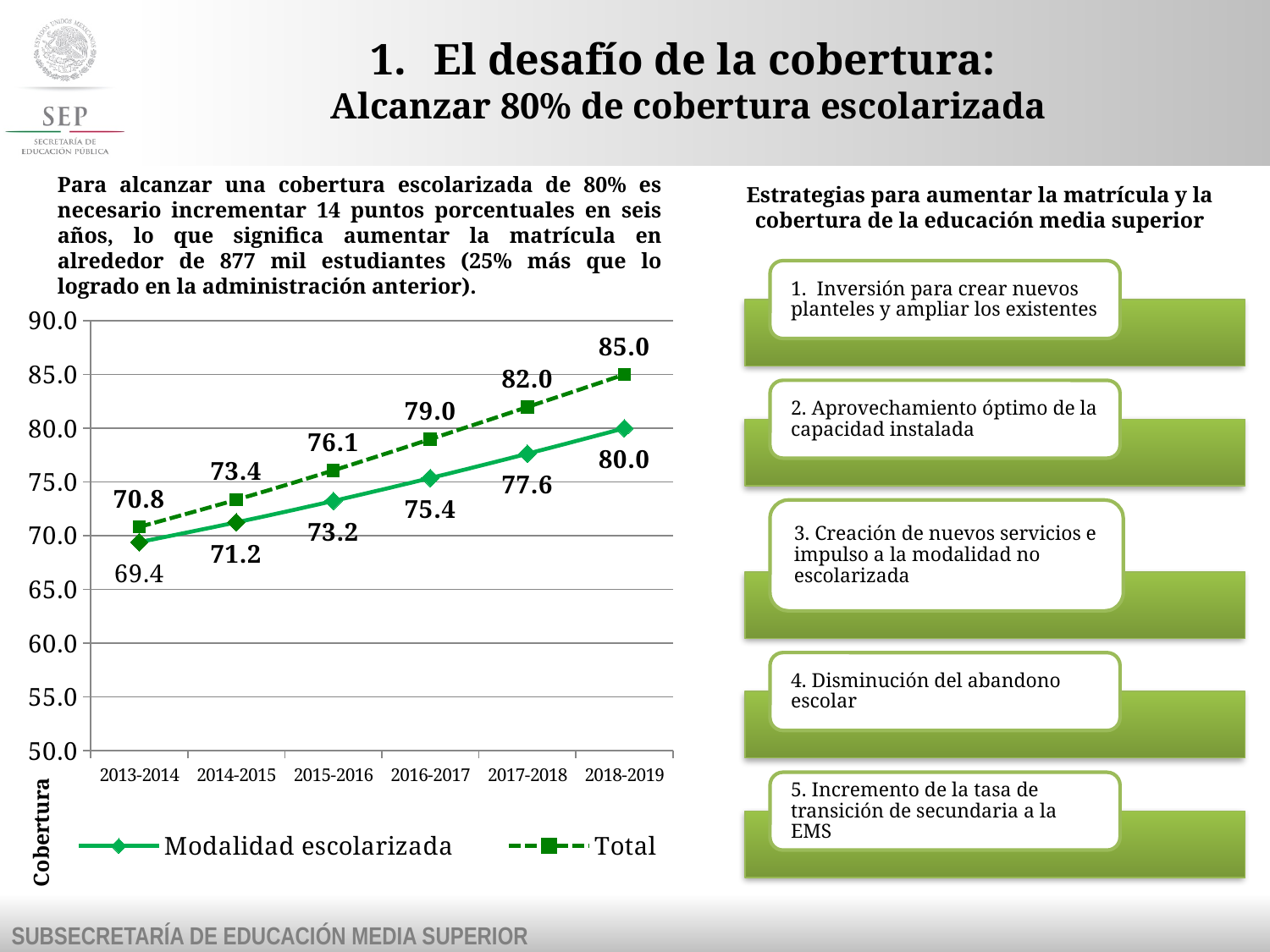
How many series does the legend list? 2 Which is larger in 2017-2018, Total or Modalidad escolarizada? Total What is the value of Total for 2018-2019? 85.0 What is the value of Total for 2015-2016? 76.1 Do the values of Modalidad escolarizada rise or fall from 2013-2014 to 2018-2019? Rise What is the value of Modalidad escolarizada for 2013-2014? 69.4 What is the difference between Total and Modalidad escolarizada in 2018-2019? 5.0 How many periods are shown on the x axis? 6 What is the value of Modalidad escolarizada for 2016-2017? 75.4 In which period is the Total series highest? 2018-2019 In which period is the Modalidad escolarizada series lowest? 2013-2014 What kind of chart is shown? Line chart